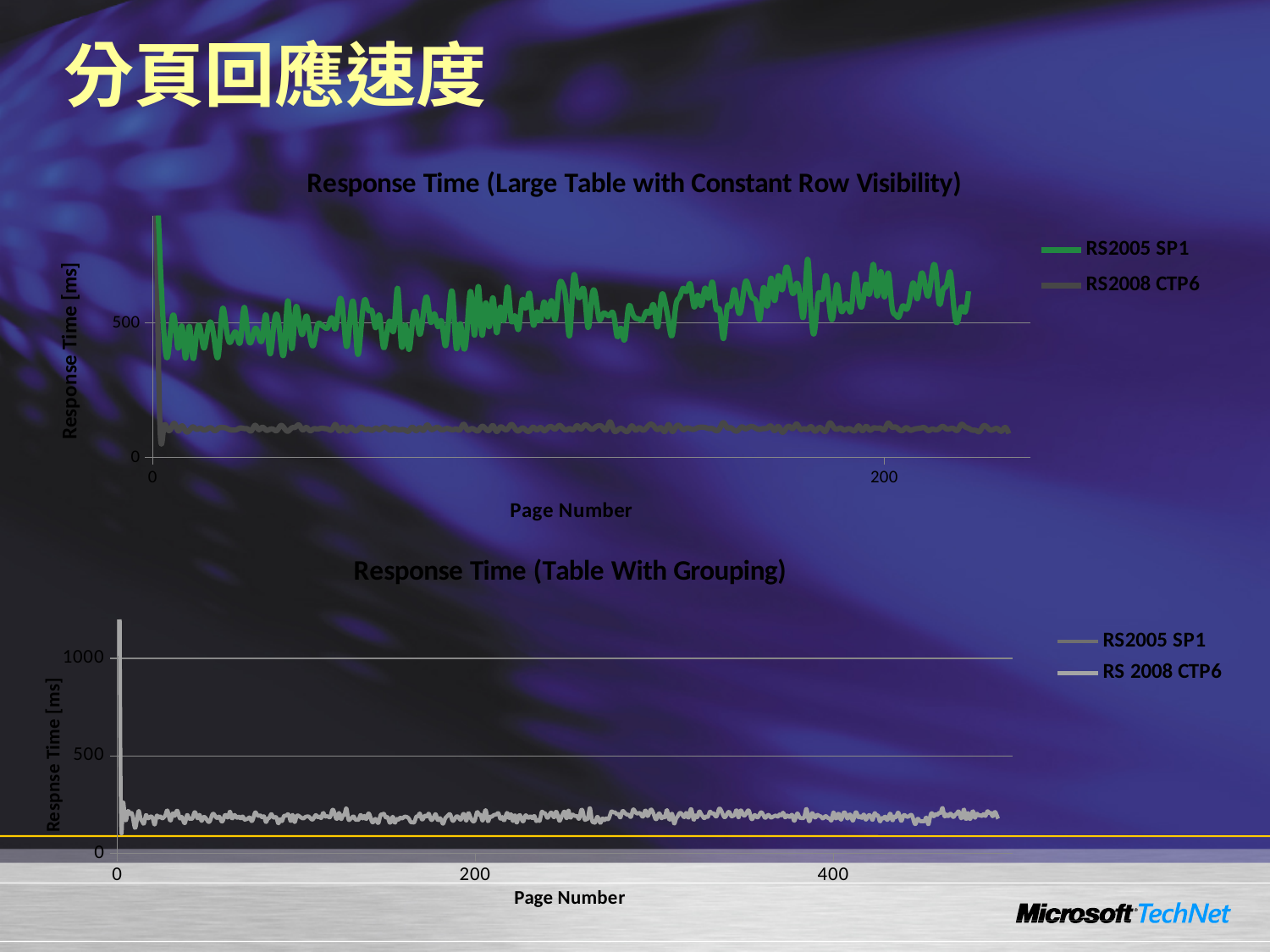
In the top chart, "Response Time (Large Table with Constant Row Visibility)", which series has the higher response times, RS2005 SP1 or RS2008 CTP6? RS2005 SP1 In the top chart, "Response Time (Large Table with Constant Row Visibility)", does the RS2005 SP1 line generally rise or fall as the page number increases? rise What kind of chart is the top chart, "Response Time (Large Table with Constant Row Visibility)"? Line chart How many series does the legend of the top chart, "Response Time (Large Table with Constant Row Visibility)", list? 2 What is the x-axis title of the top chart, "Response Time (Large Table with Constant Row Visibility)"? Page Number What kind of chart is the bottom chart, "Response Time (Table With Grouping)"? Line chart What colour is the RS2005 SP1 line in the top chart, "Response Time (Large Table with Constant Row Visibility)"? Green In the bottom chart, "Response Time (Table With Grouping)", is the value for RS 2008 CTP6 at page number 400 greater or less than 1000? less In the top chart, "Response Time (Large Table with Constant Row Visibility)", is the value for RS2008 CTP6 at page number 200 greater or less than 500? less How many series does the legend of the bottom chart, "Response Time (Table With Grouping)", list? 2